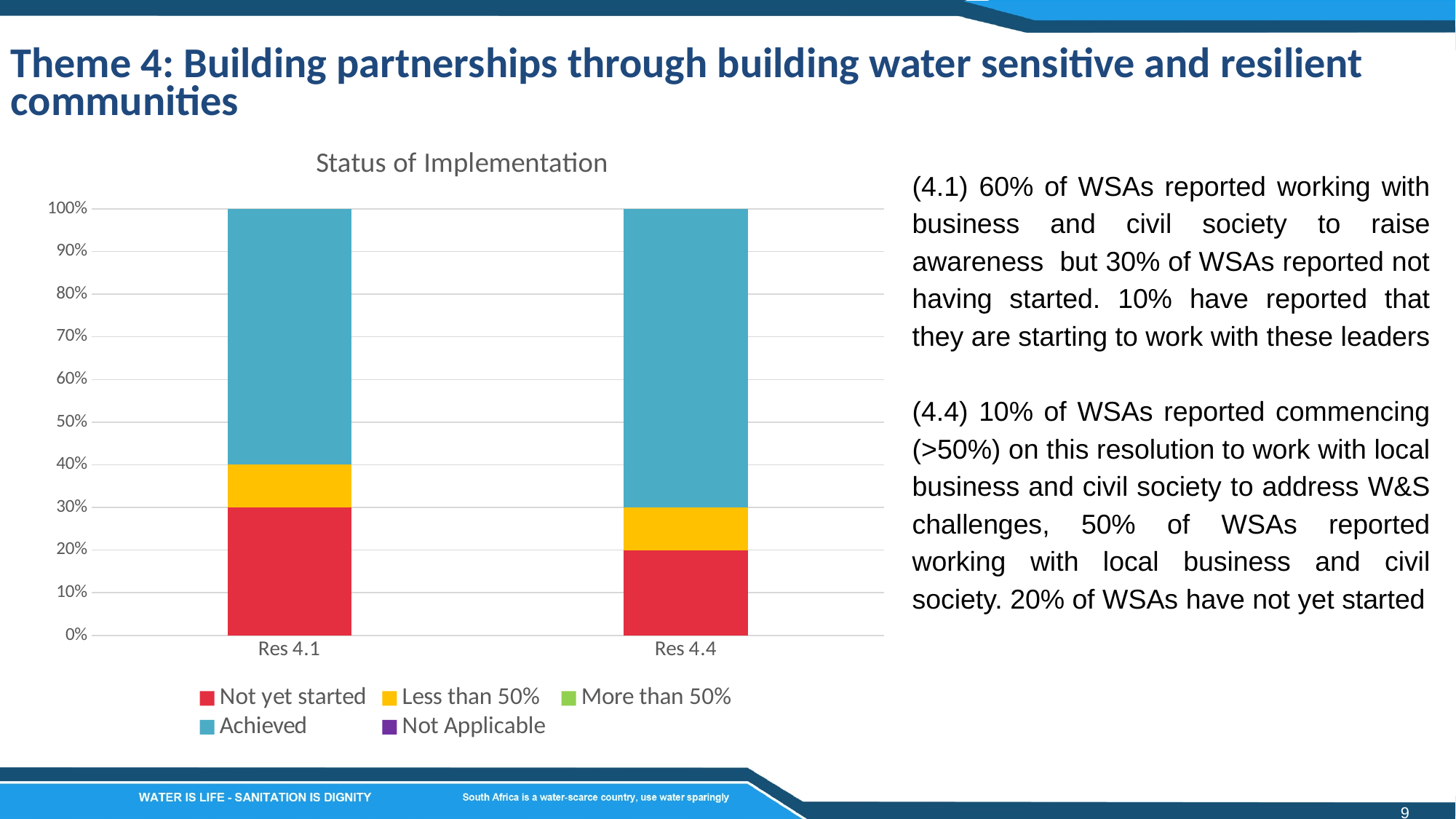
How many series does the chart legend list? 5 Is the 'Achieved' share for Res 4.1 greater or less than 50%? greater What colour represents 'Not yet started' in the chart? red How many categories are shown on the x axis of the chart? 2 What kind of chart is shown on the slide? bar chart Is the 'Less than 50%' share for Res 4.4 greater or less than 20%? less What is the 'Not yet started' value for Res 4.4? 20% What is the difference between the 'Not yet started' values for Res 4.1 and Res 4.4? 10% Which has the larger 'Not yet started' share, Res 4.1 or Res 4.4? Res 4.1 What is the 'Not yet started' value for Res 4.1? 30% Which category has the larger 'Achieved' segment? Res 4.4 What is the title of the chart? Status of Implementation